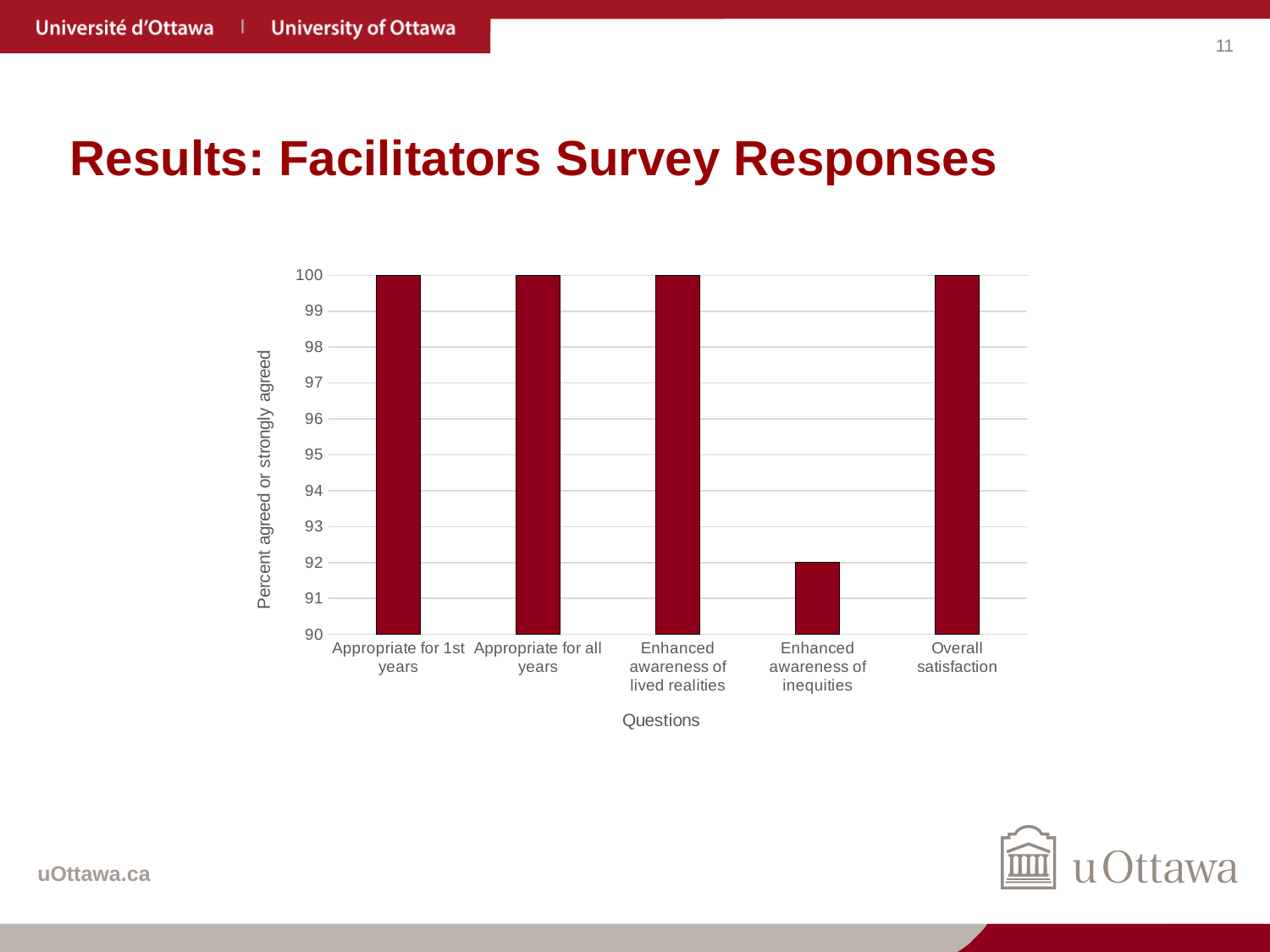
What is the label on the horizontal axis of the chart? Questions What kind of chart is shown on the slide? Bar chart Which has a higher value: 'Appropriate for all years' or 'Enhanced awareness of inequities'? Appropriate for all years What is the label on the vertical axis of the chart? Percent agreed or strongly agreed What is the difference between the value for 'Overall satisfaction' and the value for 'Enhanced awareness of inequities'? 8 What percent agreed or strongly agreed for 'Overall satisfaction'? 100 What percent agreed or strongly agreed for 'Enhanced awareness of inequities'? 92 Which question has the lowest percent agreed or strongly agreed? Enhanced awareness of inequities What percent agreed or strongly agreed for 'Appropriate for 1st years'? 100 Is the value for 'Enhanced awareness of inequities' greater or less than 95? less How many of the questions have a value of 100? 4 How many questions (categories) are plotted on the chart? 5